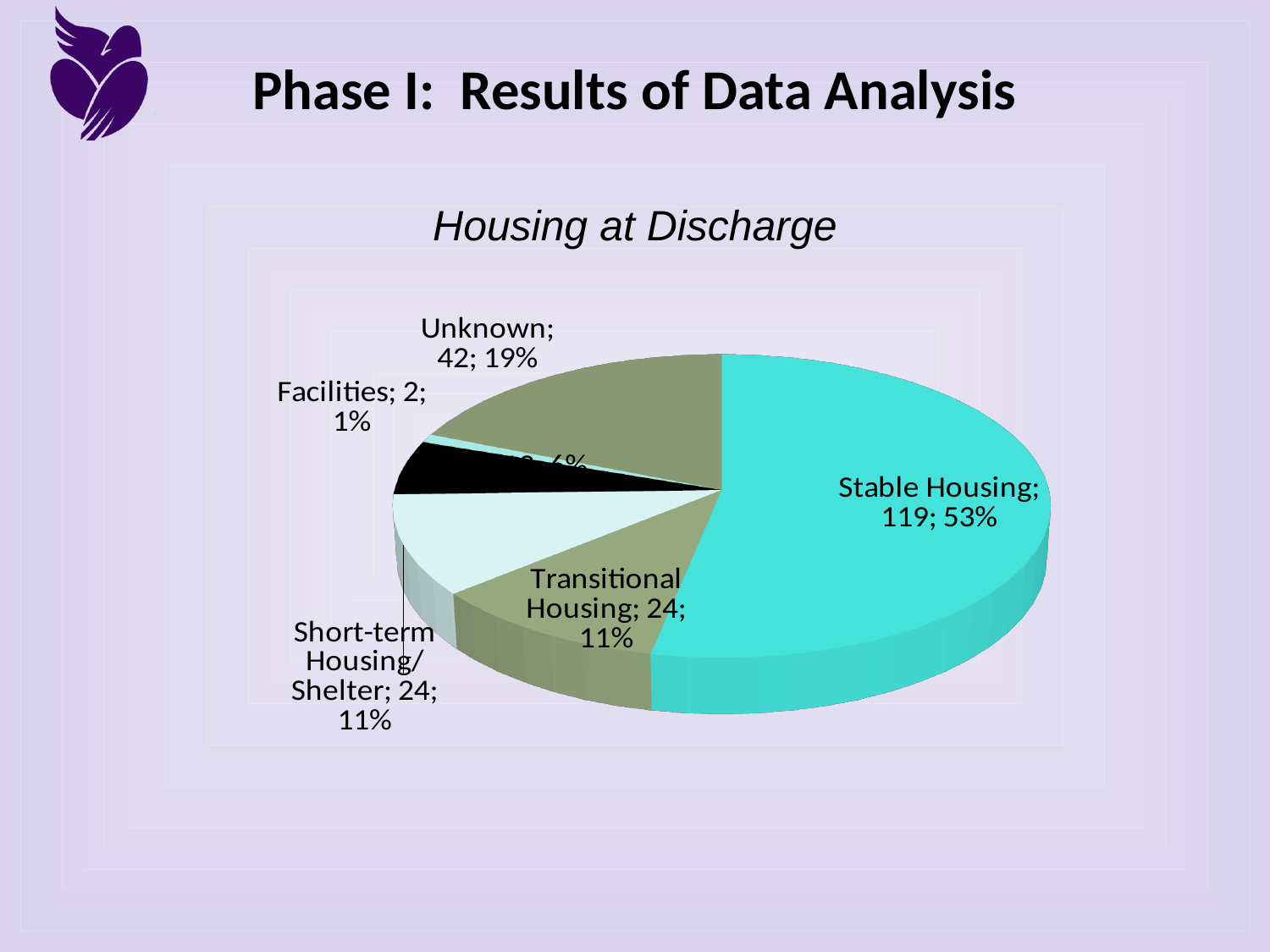
Which has more cases, Unknown or Transitional Housing? Unknown What share of the pie does Stable Housing represent? 53% What is the difference in cases between Stable Housing and Unknown? 77 Which category has the largest slice of the pie? Stable Housing What share of the pie does Unknown represent? 19% What share of the pie does Facilities represent? 1% What is the title of the chart? Housing at Discharge What kind of chart is shown on the slide? pie chart How many cases are in the Transitional Housing slice? 24 Which category has the smallest slice of the pie? Facilities How many cases are in the Unknown slice? 42 How many cases are in the Stable Housing slice? 119